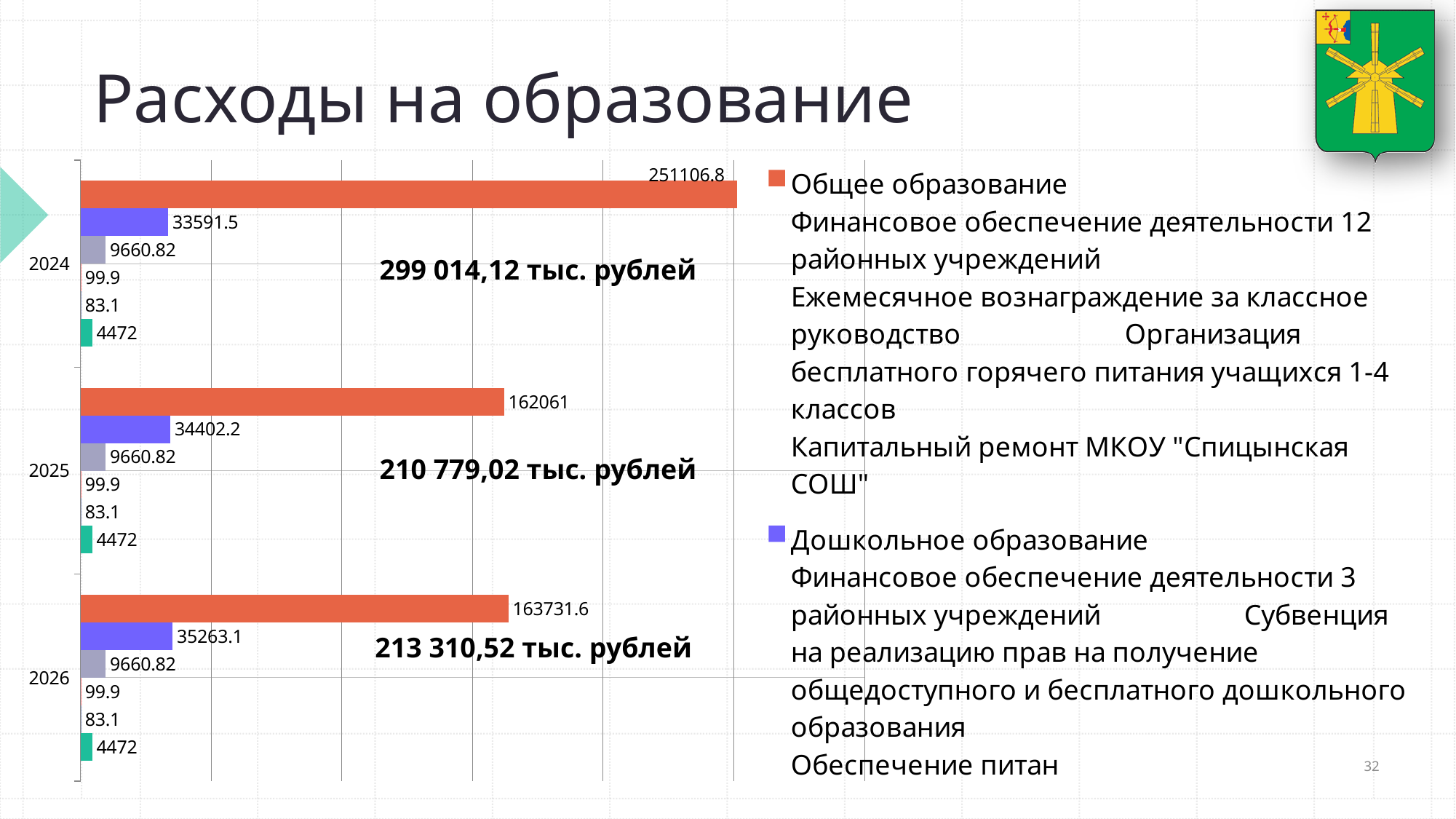
What is the value for Общее образование in 2024? 251106.8 What kind of chart is shown on the slide? bar chart What is the value for Дошкольное образование in 2024? 33591.5 How many years are shown on the chart? 3 What is the difference between the Дошкольное образование values for 2026 and 2025? 860.9 Which is larger: Общее образование in 2026 or Общее образование in 2025? 2026 In which year is the value for Дошкольное образование lowest? 2024 Do the values for Дошкольное образование rise or fall from 2024 to 2026? rise What is the difference between the Общее образование values for 2024 and 2025? 89045.8 What is the value for Дошкольное образование in 2026? 35263.1 What is the value for Общее образование in 2025? 162061 In which year is the value for Общее образование highest? 2024